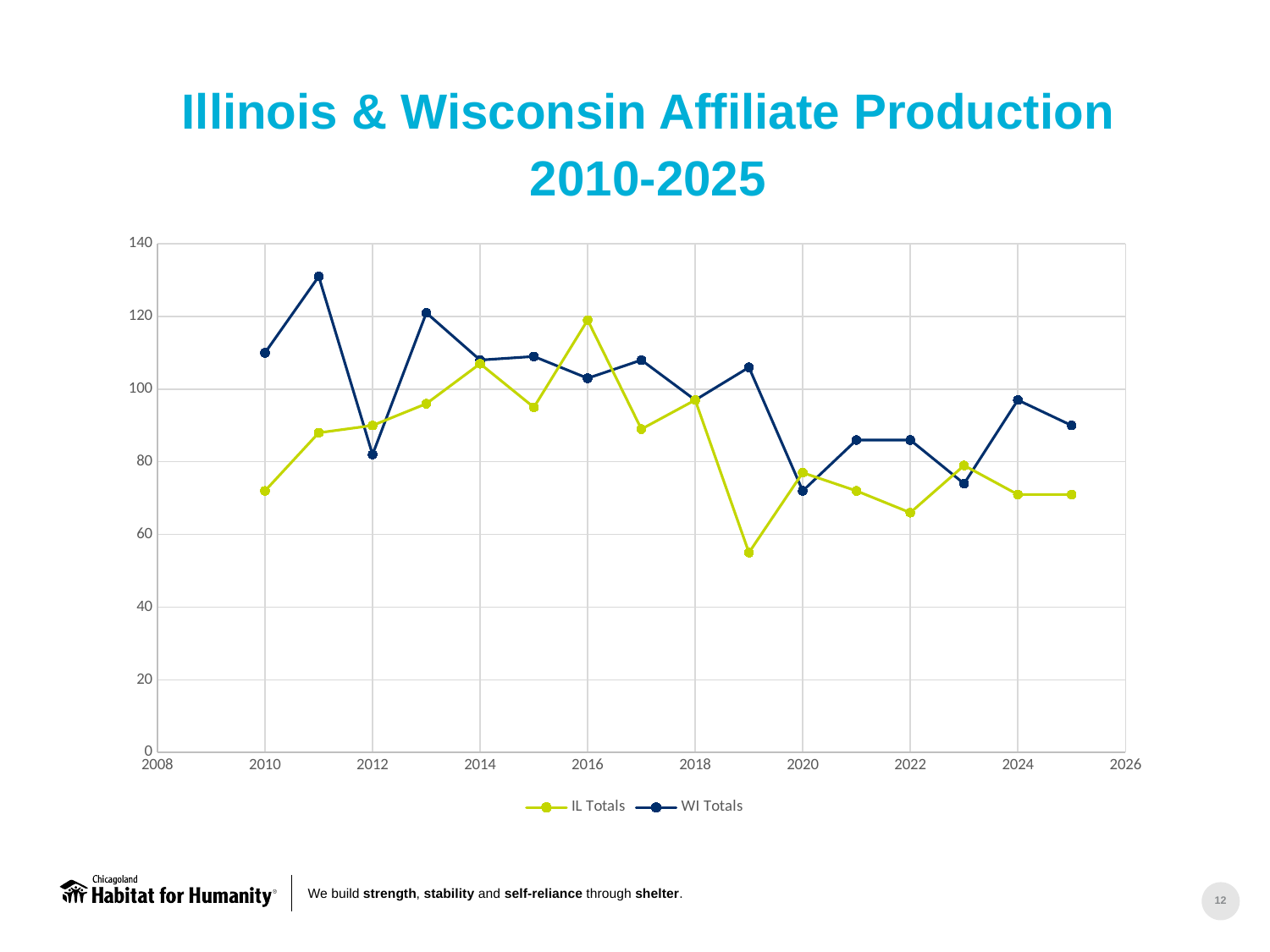
What kind of chart is shown on the slide? line chart What are the names of the two series in the legend? IL Totals and WI Totals Is the value for IL Totals in 2019 greater or less than 60? less In which year does the WI Totals series reach its highest value? 2011 How many years of data points are plotted for each series? 16 How many series does the legend list? 2 Does the IL Totals series rise or fall from 2016 to 2019? fall In which year does the IL Totals series reach its lowest value? 2019 In which year does the IL Totals series reach its highest value? 2016 In 2016, which series has the larger value, IL Totals or WI Totals? IL Totals Is the value for WI Totals in 2011 greater or less than 120? greater Is the value for IL Totals in 2010 greater or less than 80? less